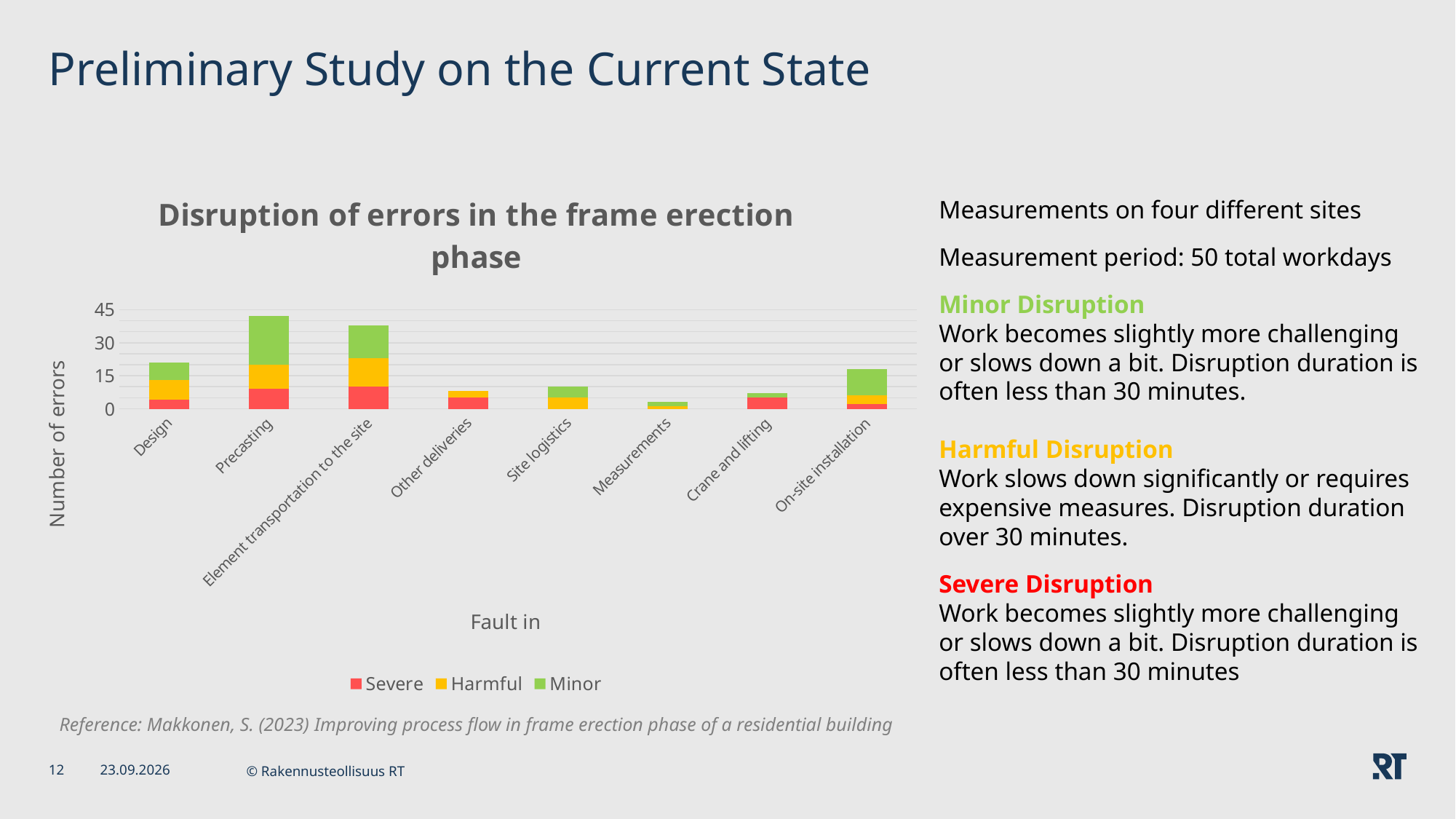
What are the three series listed in the chart legend? Severe, Harmful, Minor Which has a larger total number of errors, Precasting or Design? Precasting Which fault category has the lowest total number of errors? Measurements Which fault category has the highest total number of errors? Precasting How many fault categories are shown on the x axis of the chart? 8 How many series does the chart legend list? 3 What is the title of the chart? Disruption of errors in the frame erection phase Is the total number of errors for Precasting greater or less than 30? greater Is the total number of errors for Design greater or less than 15? greater Is the total number of errors for Other deliveries greater or less than 15? less What kind of chart is shown on the slide? Stacked bar chart